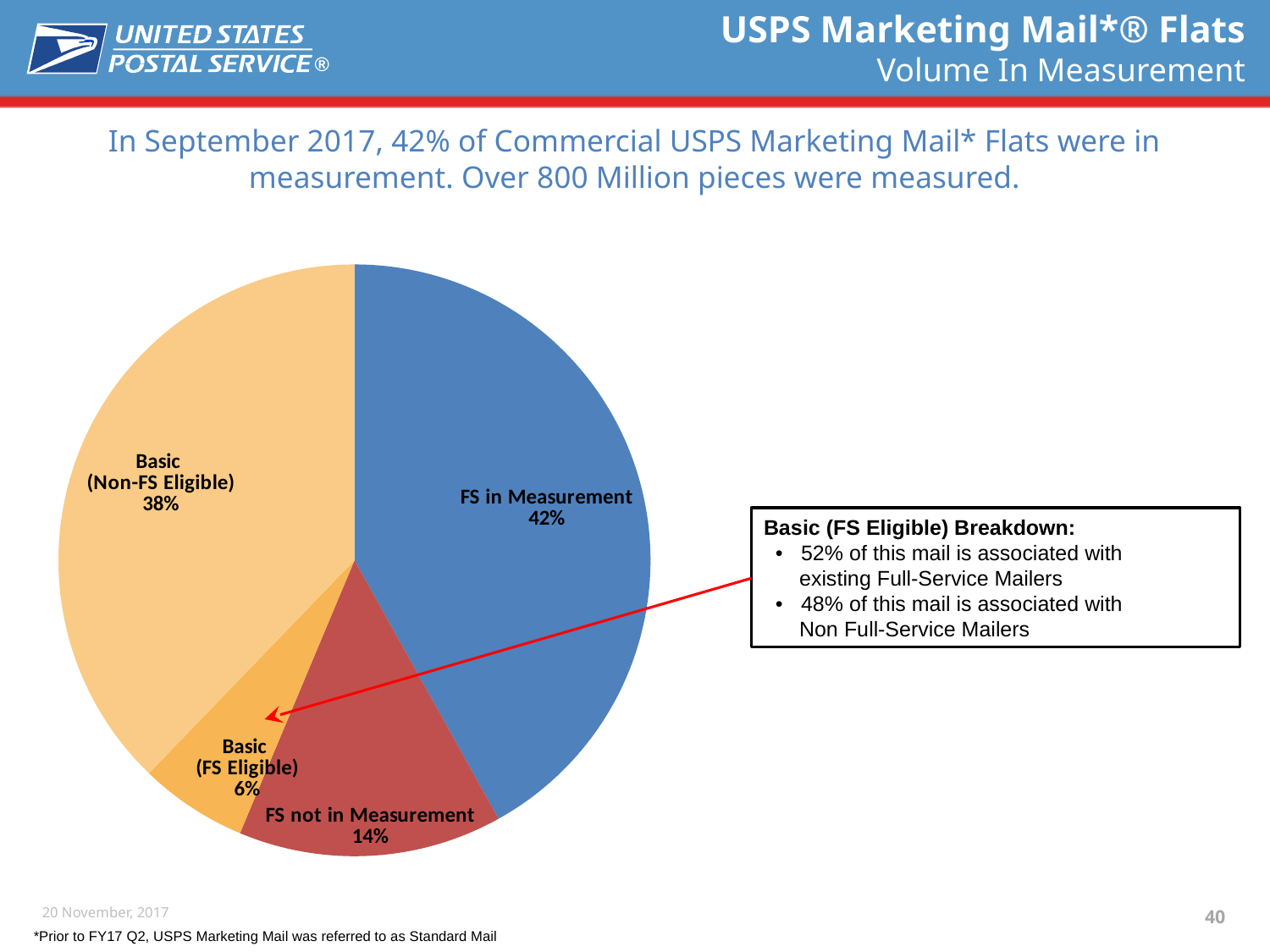
What colour is the FS in Measurement slice? blue What share of the pie is FS not in Measurement? 14% What kind of chart is shown on the slide? pie chart What is the difference in percentage points between FS in Measurement and FS not in Measurement? 28 What share of the pie is FS in Measurement? 42% Which slice of the pie is the smallest? Basic (FS Eligible) What share of the pie is Basic (FS Eligible)? 6% Which slice of the pie is the largest? FS in Measurement What is the combined share of FS in Measurement and FS not in Measurement? 56% How many slices does the pie chart have? 4 Which is larger, Basic (Non-FS Eligible) or FS not in Measurement? Basic (Non-FS Eligible)